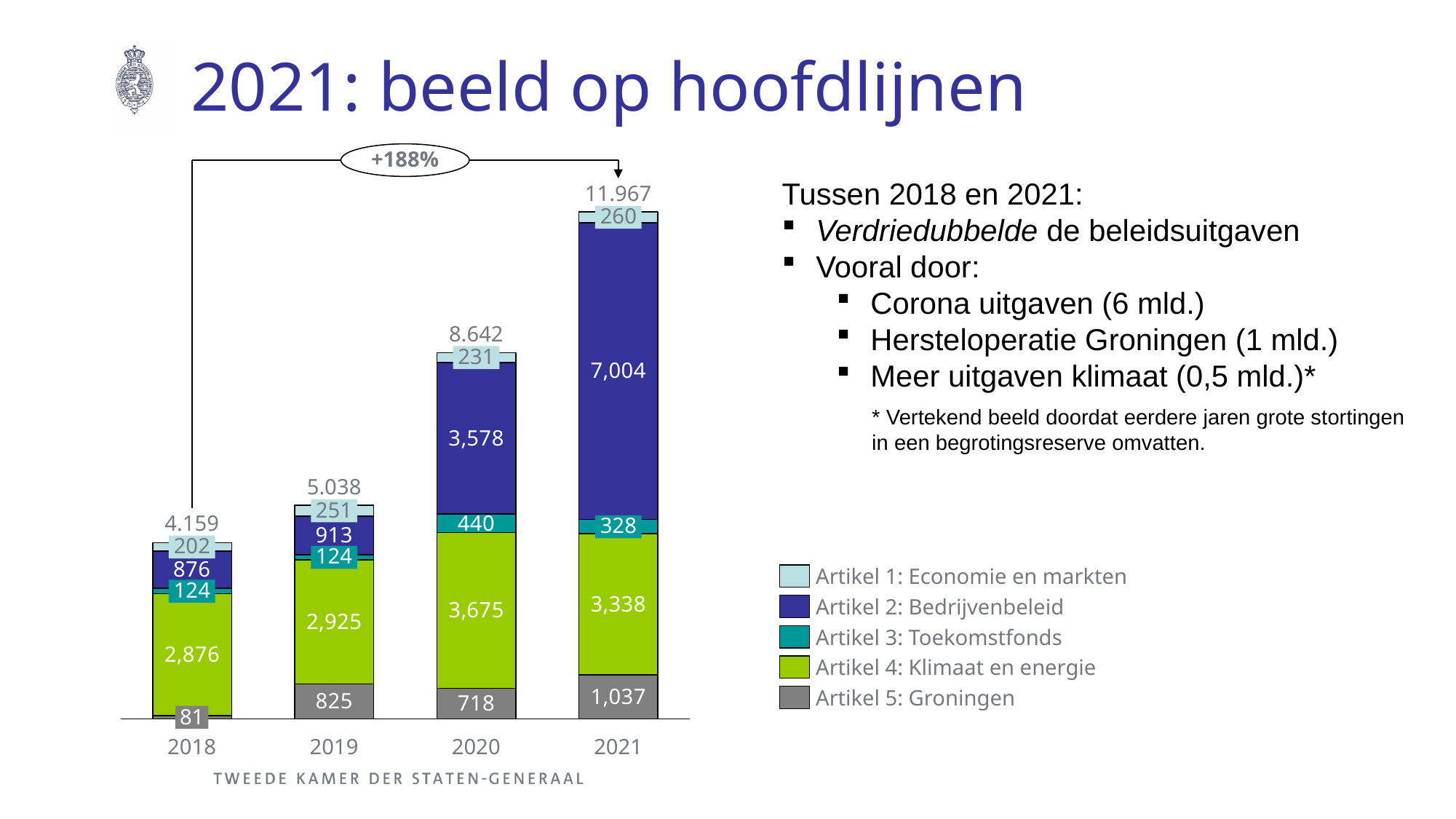
What is the total of the stacked bar for 2021? 11.967 What kind of chart is shown on the slide? Stacked bar chart Which year has the lowest value for Artikel 5: Groningen? 2018 What is the value for Artikel 5: Groningen in 2019? 825 Which is larger, the Artikel 3: Toekomstfonds value for 2020 or for 2021? 2020 How many years are shown on the x axis? 4 What is the value for Artikel 2: Bedrijvenbeleid in 2021? 7,004 What is the total of the stacked bar for 2018? 4.159 What is the difference between the Artikel 2: Bedrijvenbeleid values for 2021 and 2020? 3,426 What is the value for Artikel 4: Klimaat en energie in 2020? 3,675 How many series does the legend list? 5 Which year has the highest total? 2021